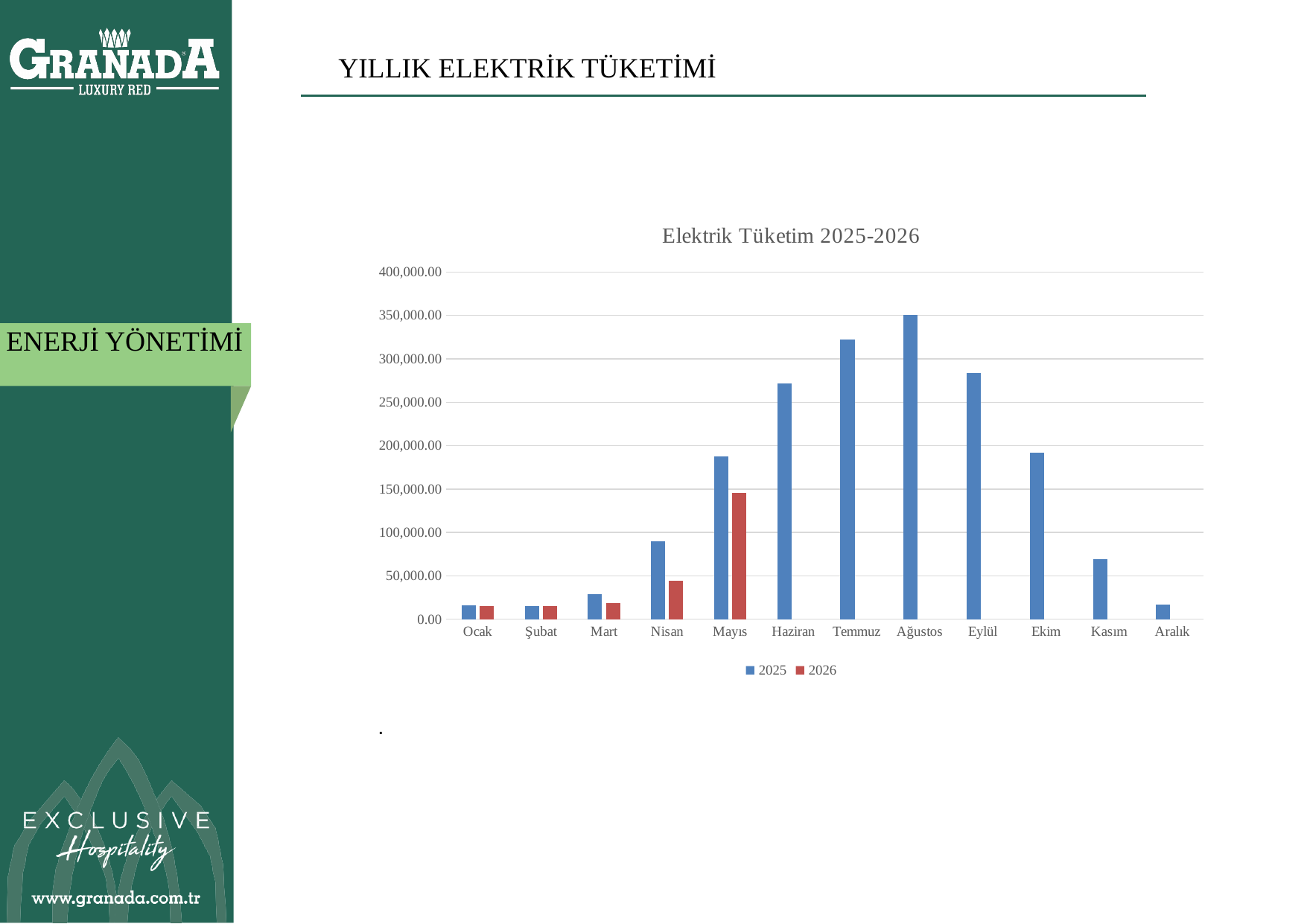
Is the 2025 value for Temmuz greater or less than 300,000.00? greater In which month is the 2025 electricity consumption highest? Ağustos What kind of chart is shown on the slide? bar chart How many months are shown on the x axis? 12 What is the title of the chart? Elektrik Tüketim 2025-2026 Is the 2026 value for Mayıs greater or less than 100,000.00? greater How many series does the legend list? 2 Do the 2025 values rise or fall from Ocak to Ağustos? rise Is the 2025 value for Kasım greater or less than 50,000.00? greater Which month has the larger 2025 value: Temmuz or Eylül? Temmuz Which is larger for Mayıs: the 2025 value or the 2026 value? 2025